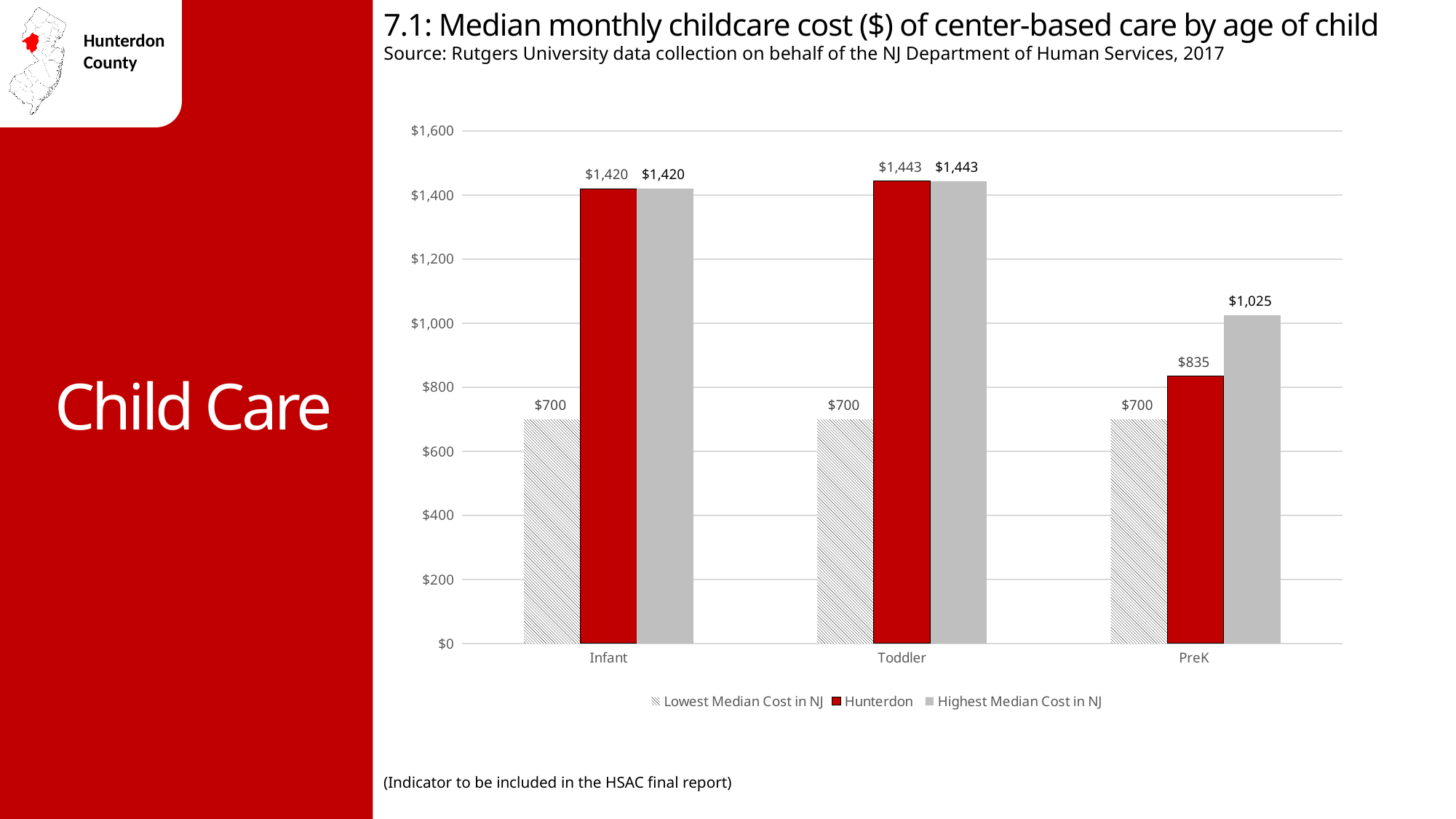
What is the difference between the Highest Median Cost in NJ and the Hunterdon cost for PreK care? $190 For which age group is the Hunterdon median monthly cost the lowest? PreK How many series does the legend list? 3 What is the Hunterdon median monthly childcare cost for Infant care? $1,420 What is the Highest Median Cost in NJ for PreK care? $1,025 Which is larger: the Hunterdon cost for Infant care or the Hunterdon cost for PreK care? Infant For which age group is the Hunterdon median monthly cost the highest? Toddler What type of chart is shown on the slide? Bar chart What is the Hunterdon median monthly cost for Toddler care? $1,443 What is the difference between the Hunterdon cost and the Lowest Median Cost in NJ for Infant care? $720 What is the Lowest Median Cost in NJ for Toddler care? $700 How many age groups are shown on the x axis? 3